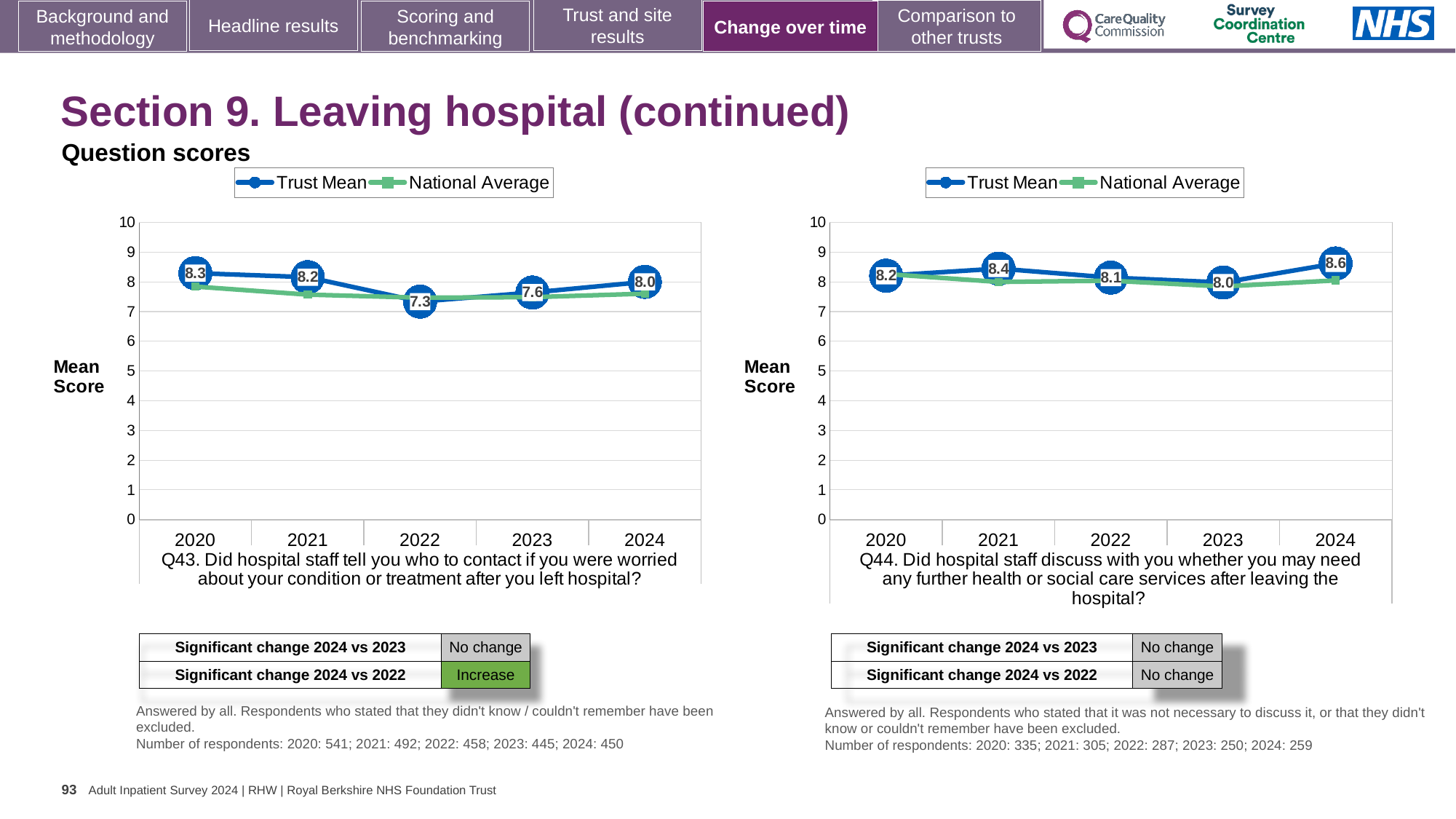
In the Q43 chart (left), what is the Trust Mean score for 2022? 7.3 In the Q43 chart (left), is the Trust Mean score higher in 2021 or in 2023? 2021 In the Q43 chart (left), which year has the lowest Trust Mean score? 2022 How many series does the legend of the Q43 chart (left) list? 2 In the Q44 chart (right), which year has the highest Trust Mean score? 2024 In the Q44 chart (right), what is the difference between the Trust Mean scores for 2024 and 2023? 0.6 In the Q43 chart (left), what is the Trust Mean score for 2024? 8.0 In the Q44 chart (right), what is the Trust Mean score for 2021? 8.4 In the Q43 chart (left), what is the difference between the Trust Mean scores for 2020 and 2022? 1.0 In the Q44 chart (right), what is the Trust Mean score for 2024? 8.6 What type of chart is the Q44 chart (right)? Line chart How many years are plotted on the x axis of the Q44 chart (right)? 5